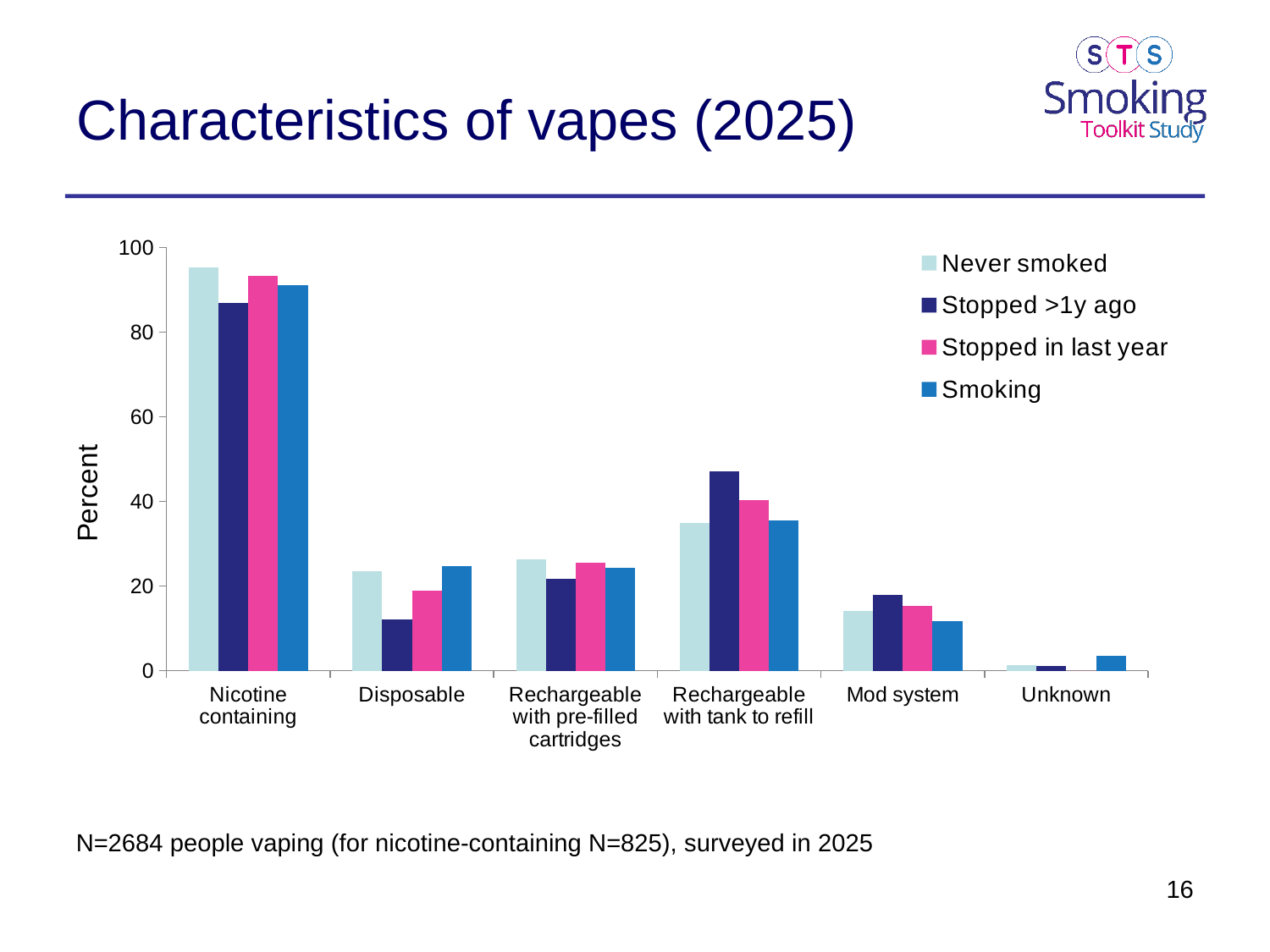
Which category has the highest values across all series? Nicotine containing How many series does the legend list? 4 Is the value for Smoking in the Mod system category greater or less than 20? less What is the label on the y axis? Percent In the Disposable category, which series has the lowest value? Stopped >1y ago What kind of chart is shown on the slide? bar chart In the Rechargeable with tank to refill category, which series has the highest value? Stopped >1y ago In the Nicotine containing category, which is larger: Never smoked or Stopped >1y ago? Never smoked Is the value for Never smoked in the Nicotine containing category greater or less than 80? greater Is the value for Stopped >1y ago in the Disposable category greater or less than 20? less How many categories are shown along the x axis? 6